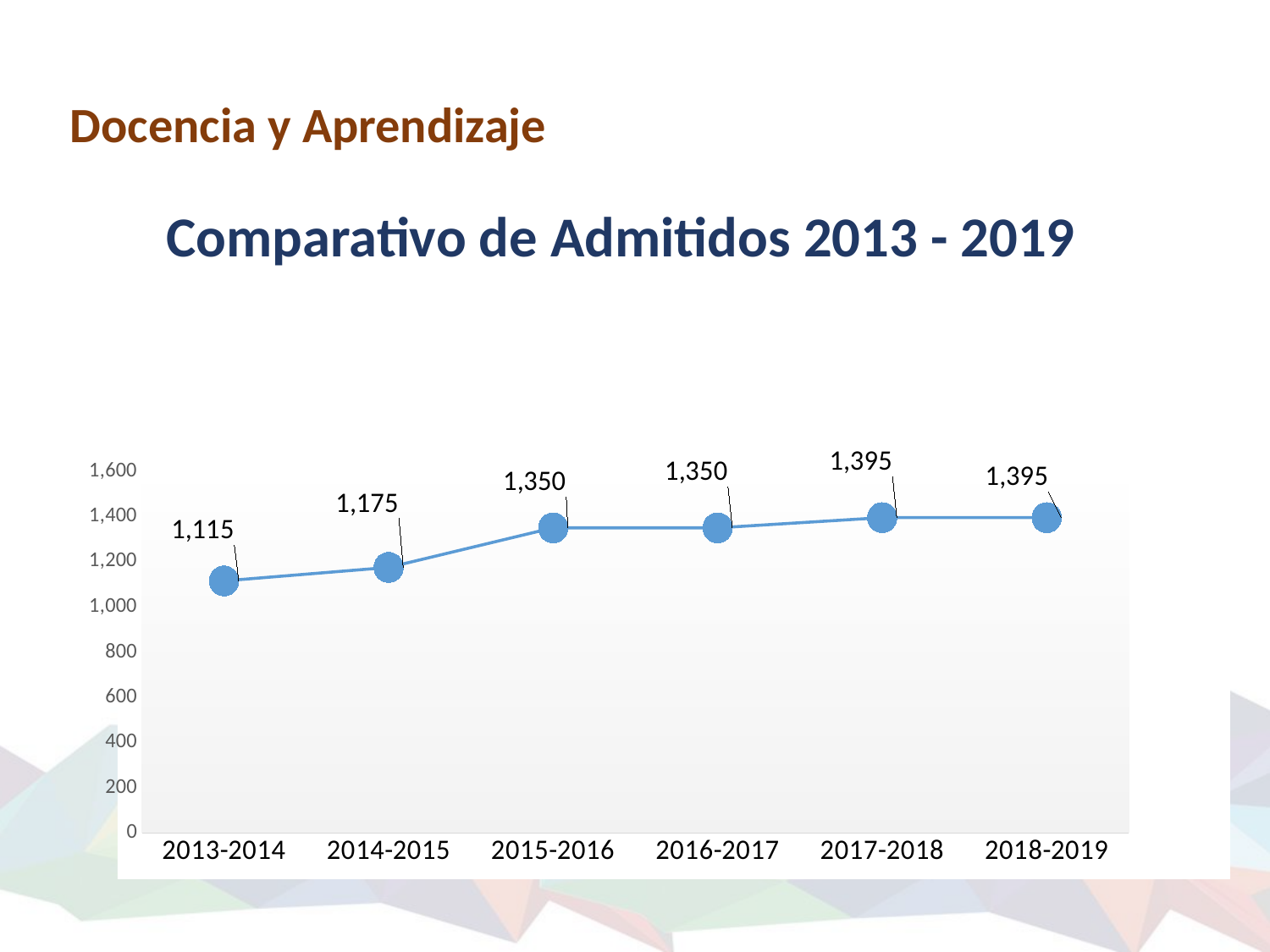
What is the difference between the values for 2018-2019 and 2013-2014? 280 Which is larger, the value for 2014-2015 or the value for 2015-2016? 2015-2016 What is the value for 2016-2017? 1,350 What kind of chart is shown on the slide? line chart Is the value for 2013-2014 greater or less than 1,200? less What is the difference between the values for 2015-2016 and 2014-2015? 175 What is the value for 2018-2019? 1,395 What is the value for 2013-2014? 1,115 What is the value for 2014-2015? 1,175 How many periods are plotted on the chart? 6 Do the values generally rise or fall from 2013-2014 to 2018-2019? rise Which period has the lowest value? 2013-2014